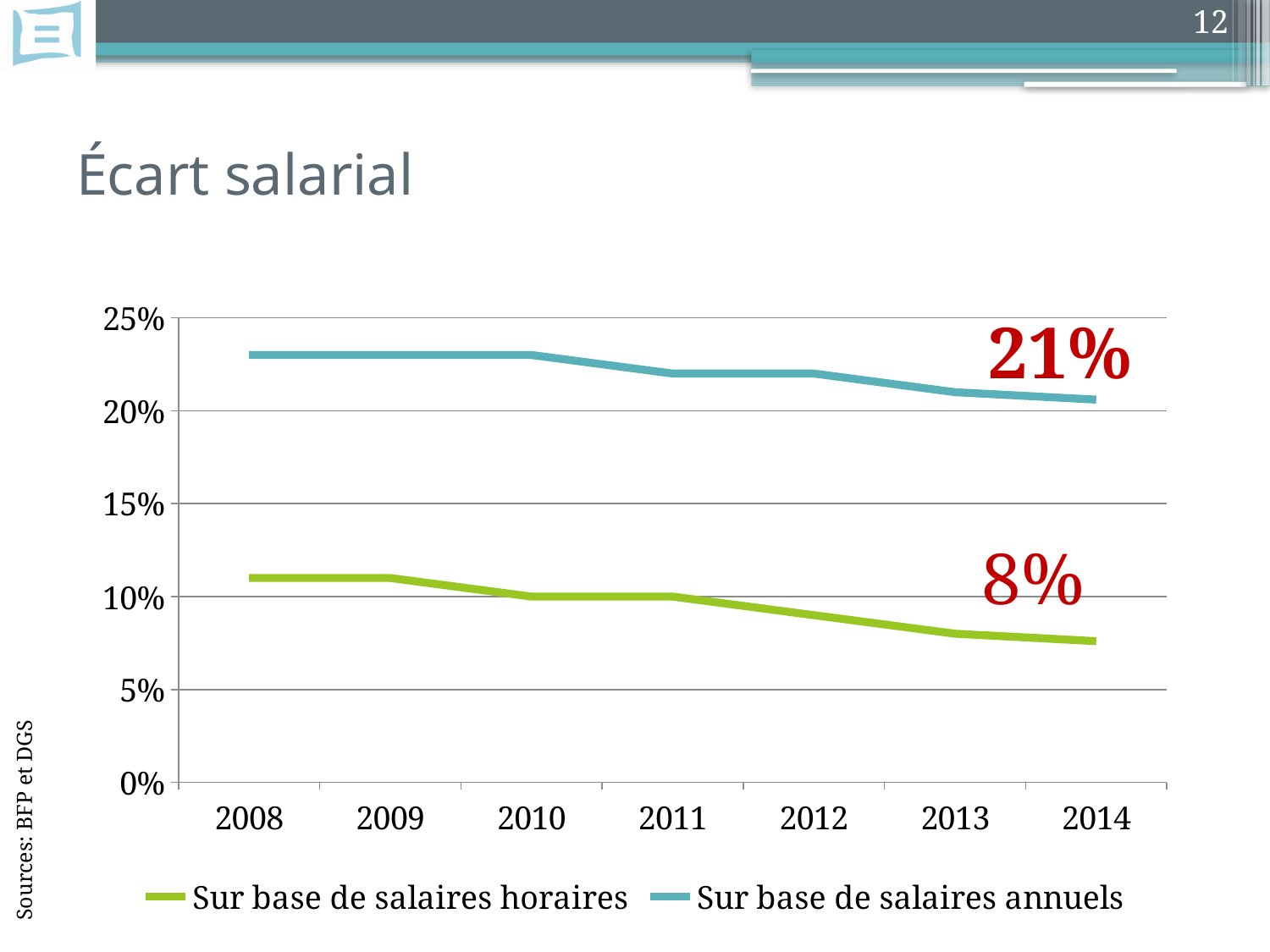
What value is labelled for 'Sur base de salaires annuels' at the end of the series in 2014? 21% Which series is higher in 2014, 'Sur base de salaires annuels' or 'Sur base de salaires horaires'? Sur base de salaires annuels How many series does the legend list? 2 What is the title of the chart on the slide? Écart salarial Is the value for 'Sur base de salaires annuels' in 2008 greater or less than 20%? greater What kind of chart is shown on the slide? line chart What value is labelled for 'Sur base de salaires horaires' at the end of the series in 2014? 8% Is the value for 'Sur base de salaires horaires' in 2013 greater or less than 10%? less What is the difference between the labelled 2014 values of the two series (21% and 8%)? 13% Do the values for 'Sur base de salaires horaires' rise or fall from 2008 to 2014? fall Is the value for 'Sur base de salaires annuels' in 2014 greater or less than 15%? greater How many years are shown on the x axis? 7